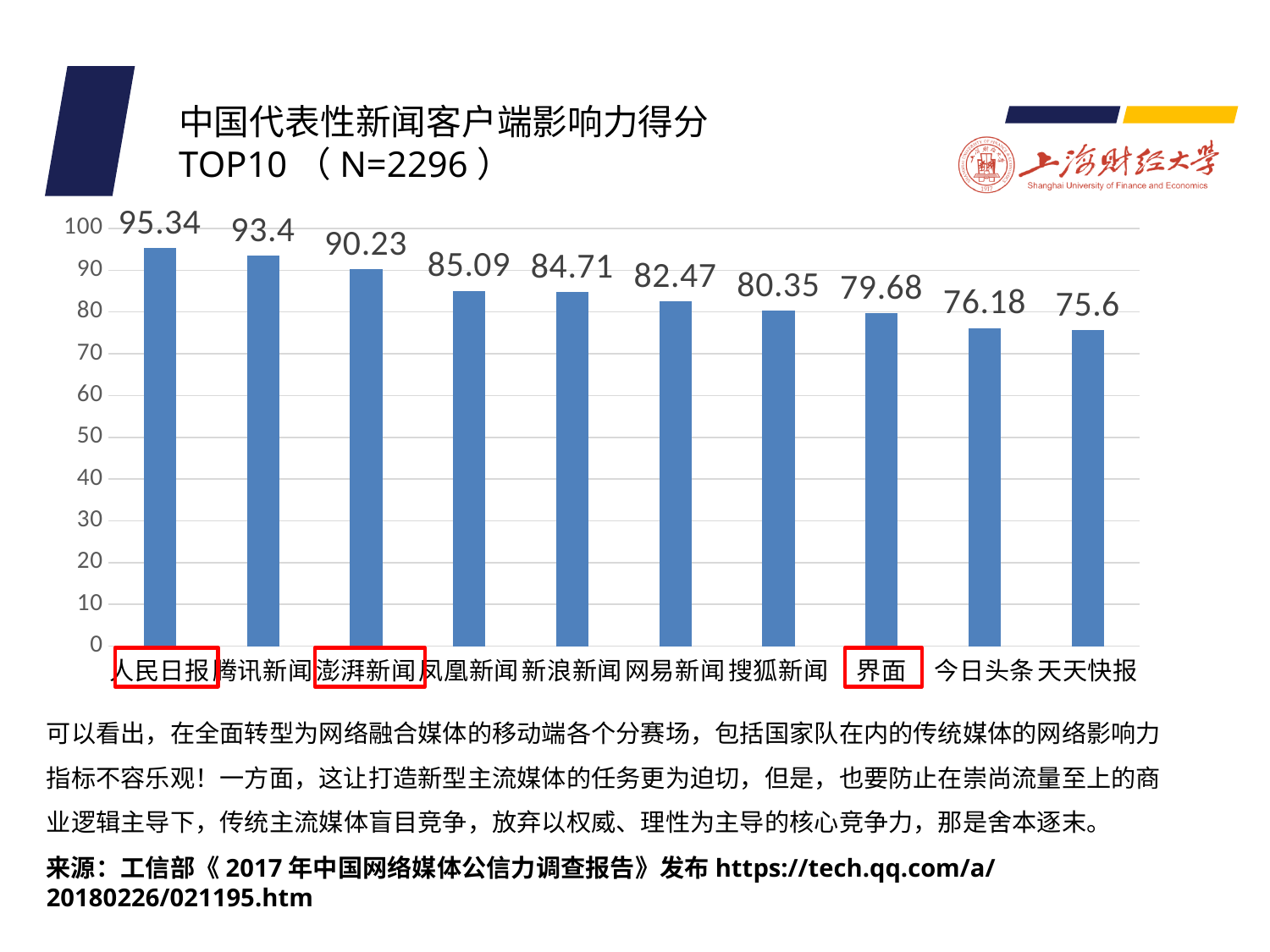
What is the influence score for 澎湃新闻? 90.23 Which has a higher score, 凤凰新闻 or 搜狐新闻? 凤凰新闻 Do the scores rise or fall from left to right across the chart? fall What is the difference between the scores of 人民日报 and 腾讯新闻? 1.94 Is the value for 今日头条 greater or less than 80? less What is the influence score for 天天快报? 75.6 How many news clients are shown in the chart? 10 What kind of chart is shown on the slide? bar chart Which news client has the highest influence score? 人民日报 Which news client has the lowest influence score? 天天快报 What is the influence score for 界面? 79.68 What is the influence score for 人民日报? 95.34